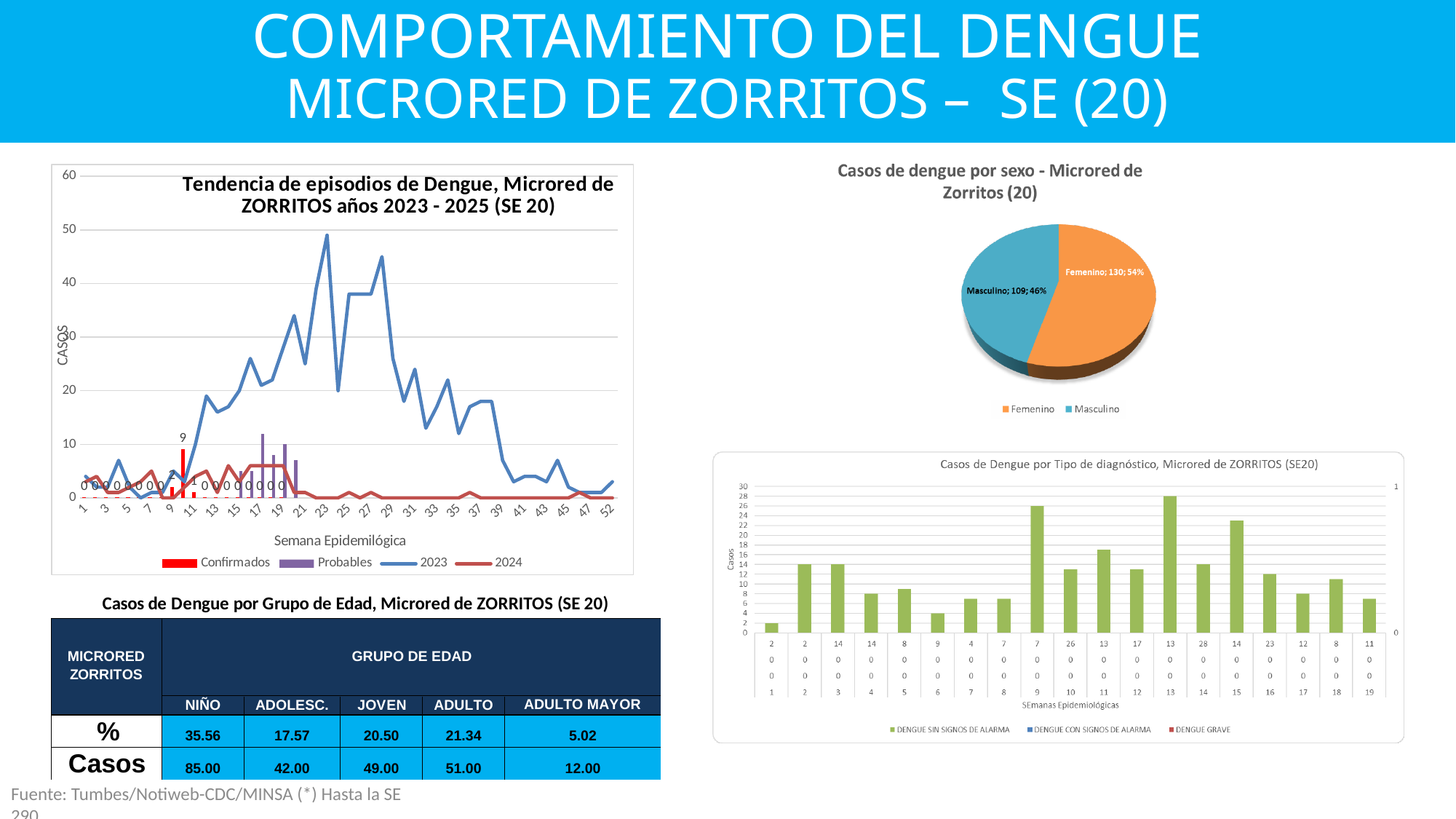
In the bar chart 'Casos de Dengue por Tipo de diagnóstico', what is the difference between the values for week 14 and week 10? 2 In the bar chart 'Casos de Dengue por Tipo de diagnóstico', how many series does the legend list? 3 In the bar chart 'Casos de Dengue por Tipo de diagnóstico', how many epidemiological weeks are shown on the x axis? 19 In the pie chart 'Casos de dengue por sexo', how many cases are Femenino? 130 In the pie chart 'Casos de dengue por sexo', which slice is larger, Femenino or Masculino? Femenino In the bar chart 'Casos de Dengue por Tipo de diagnóstico', what is the value for DENGUE SIN SIGNOS DE ALARMA in week 14? 28 In the chart 'Tendencia de episodios de Dengue', what is the labelled value of Confirmados at week 9? 2 In the pie chart 'Casos de dengue por sexo', what share of cases is Masculino? 46% In the pie chart 'Casos de dengue por sexo', what is the difference between the Femenino and Masculino case counts? 21 What kind of chart is 'Casos de Dengue por Tipo de diagnóstico, Microred de ZORRITOS (SE20)'? bar chart In the bar chart 'Casos de Dengue por Tipo de diagnóstico', which epidemiological week has the highest number of cases? 14 In the chart 'Tendencia de episodios de Dengue', is the peak value of the 2023 line greater or less than 40? greater